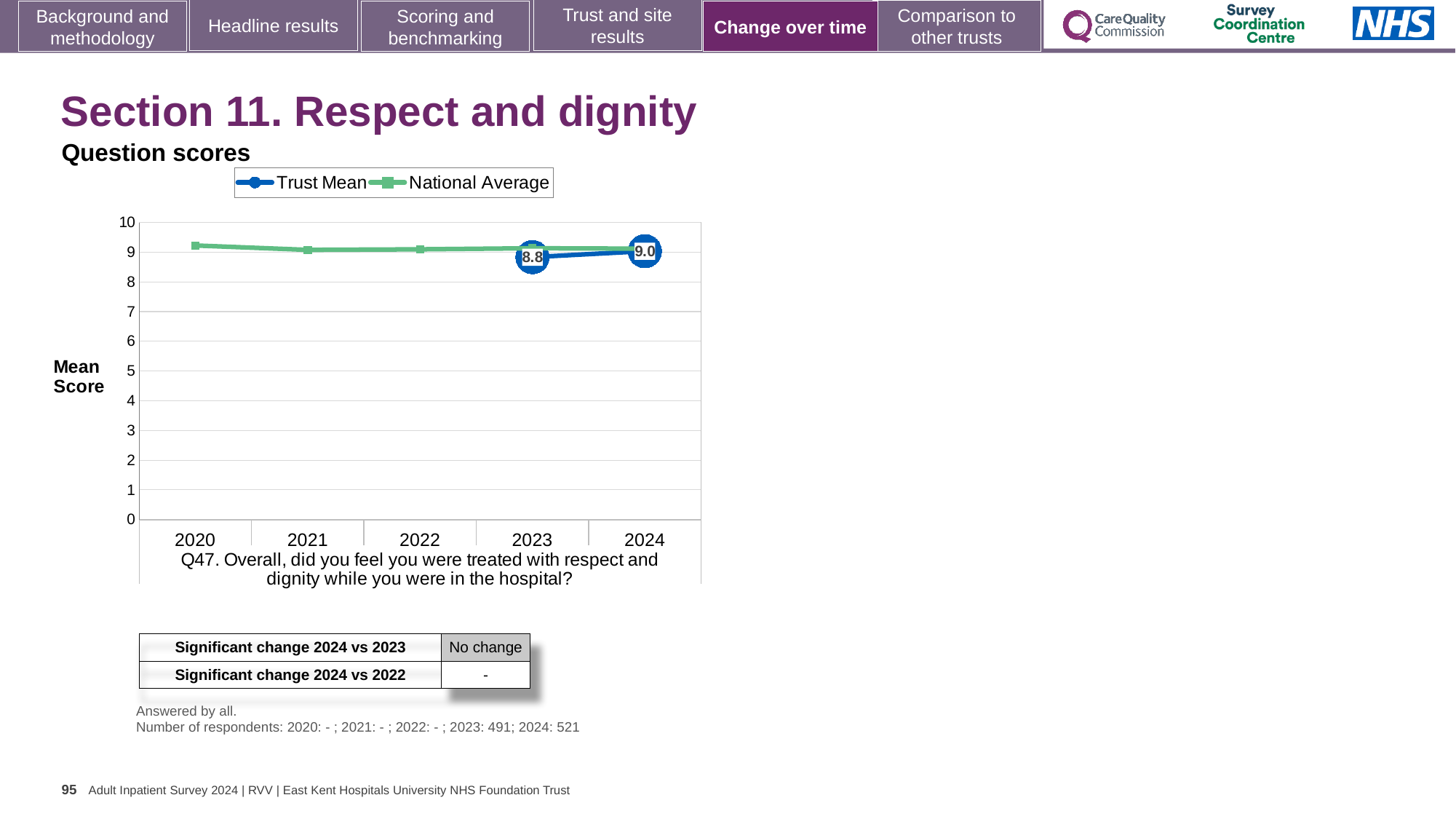
What are the two series named in the chart legend? Trust Mean and National Average In which year is the Trust Mean at its lowest? 2023 How many series does the chart legend list? 2 In which year is the Trust Mean at its highest? 2024 Which year has the higher Trust Mean value, 2023 or 2024? 2024 Is the National Average value for 2020 greater or less than 8? greater What is the Trust Mean value for 2023? 8.8 What is the difference between the Trust Mean values for 2024 and 2023? 0.2 What is the Trust Mean value for 2024? 9.0 What kind of chart is shown on the slide? line chart Does the Trust Mean rise or fall from 2023 to 2024? rise How many years are shown on the x axis of the chart? 5